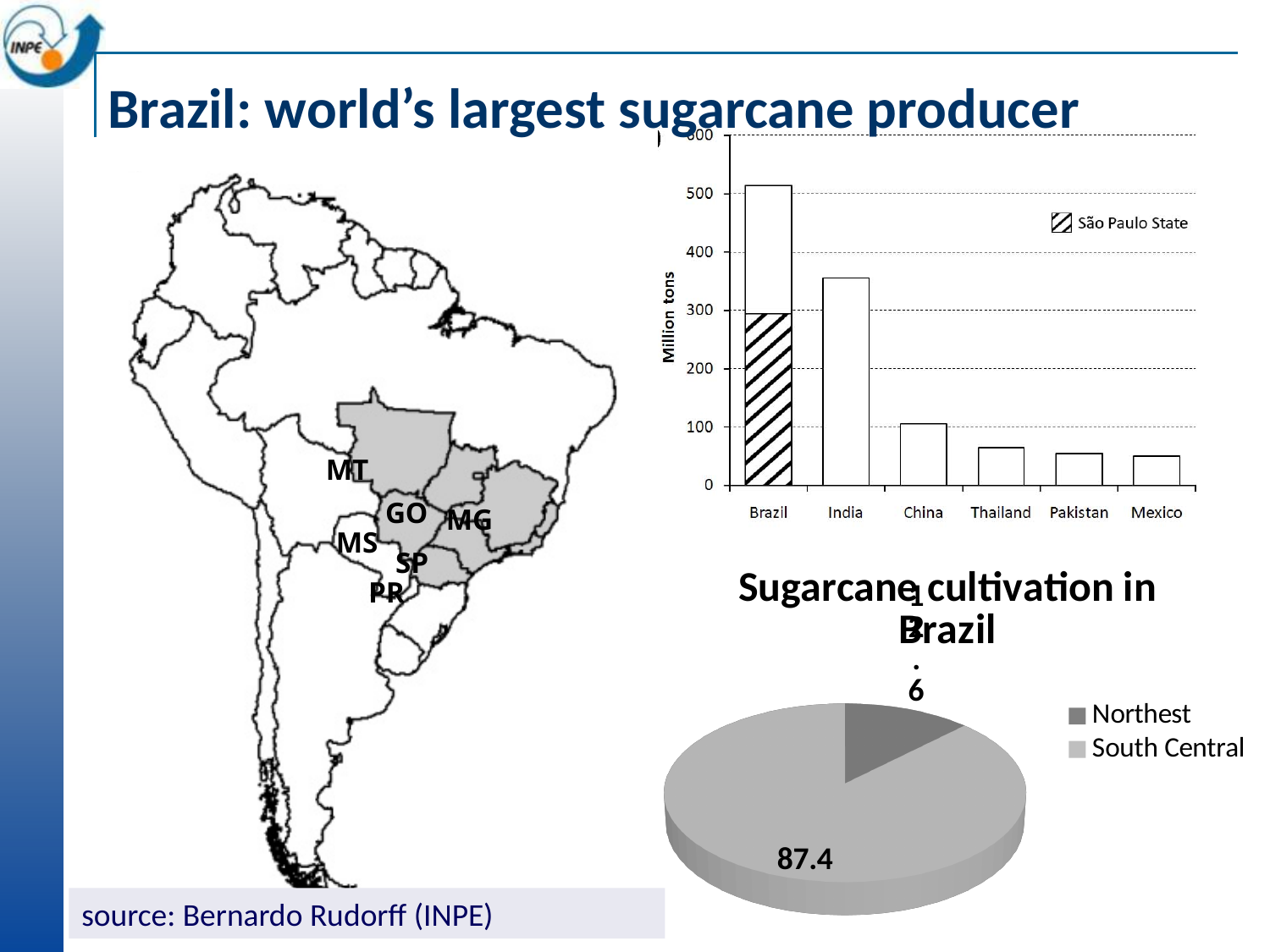
In the top-right bar chart, how many countries are shown on the x axis? 6 What kind of chart is 'Sugarcane cultivation in Brazil'? pie chart In the top-right bar chart, is the value for China greater or less than 200? less How many entries does the legend of the 'Sugarcane cultivation in Brazil' pie chart list? 2 In the top-right bar chart, which country has the highest sugarcane production? Brazil In the top-right bar chart, what does the hatched portion of the Brazil bar represent according to the legend? São Paulo State What kind of chart is the top-right chart comparing sugarcane production by country? bar chart In the top-right bar chart, which has the larger value, India or China? India In the top-right bar chart, is the value for Brazil greater or less than 400? greater In the top-right bar chart, do the values rise or fall from left to right along the x axis? fall In the 'Sugarcane cultivation in Brazil' pie chart, what is the value shown for South Central? 87.4 In the top-right bar chart, is the value for India greater or less than 400? less